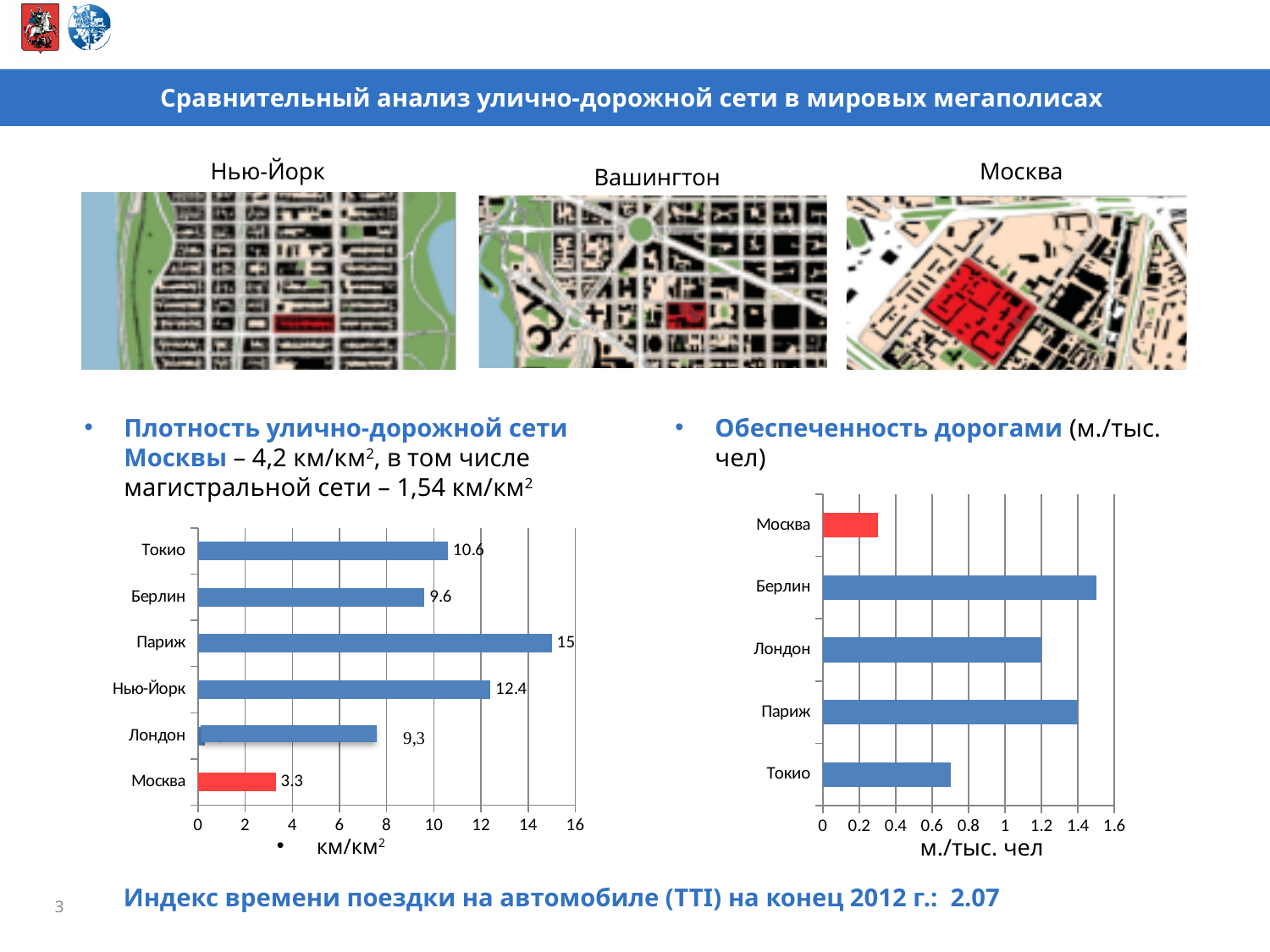
On the left chart (км/км²), what is the value for Москва? 3.3 On the right chart (м./тыс. чел), is the value for Москва greater or less than 0.4? less On the left chart (км/км²), what is the difference between the values for Париж and Москва? 11.7 On the right chart (м./тыс. чел), which city has the lowest value? Москва On the left chart (км/км²), which is larger, the value for Токио or the value for Берлин? Токио On the left chart (км/км²), which city has the highest value? Париж On the left chart (км/км²), what is the value for Нью-Йорк? 12.4 On the left chart (км/км²), how many cities are shown? 6 On the left chart (км/км²), which city has the lowest value? Москва What type of chart is the right chart (м./тыс. чел)? Bar chart On the right chart (м./тыс. чел), is the value for Берлин greater or less than 1.4? greater On the left chart (км/км²), what is the value for Париж? 15